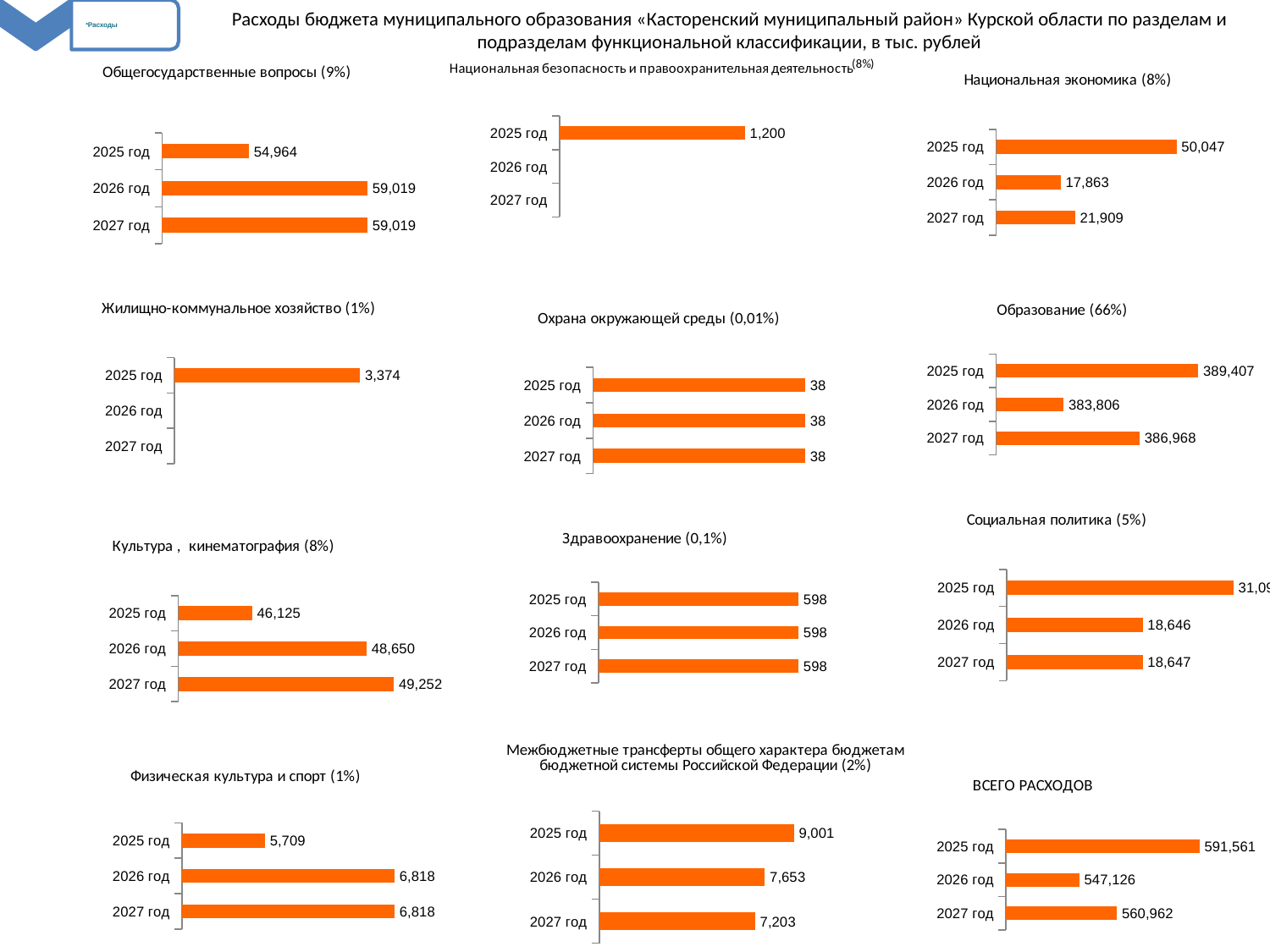
In the chart titled «Культура, кинематография (8%)», do the values rise or fall from 2025 год to 2027 год? rise In the chart titled «ВСЕГО РАСХОДОВ», what is the value for 2027 год? 560,962 In the chart titled «Жилищно-коммунальное хозяйство (1%)», what is the value for 2025 год? 3,374 In the chart titled «Национальная экономика (8%)», what is the difference between the values for 2025 год and 2027 год? 28,138 What type of chart is used for «Социальная политика (5%)»? bar chart In the chart titled «Физическая культура и спорт (1%)», how many years are shown? 3 In the chart titled «Здравоохранение (0,1%)», what is the value for 2027 год? 598 In the chart titled «Общегосударственные вопросы (9%)», what is the value for 2025 год? 54,964 In the chart titled «Образование (66%)», which year has the lowest value? 2026 год In the chart titled «Межбюджетные трансферты общего характера бюджетам бюджетной системы Российской Федерации (2%)», what is the value for 2026 год? 7,653 In the chart titled «Национальная экономика (8%)», which year has the highest value? 2025 год In the chart titled «ВСЕГО РАСХОДОВ», which is larger, the value for 2026 год or 2027 год? 2027 год